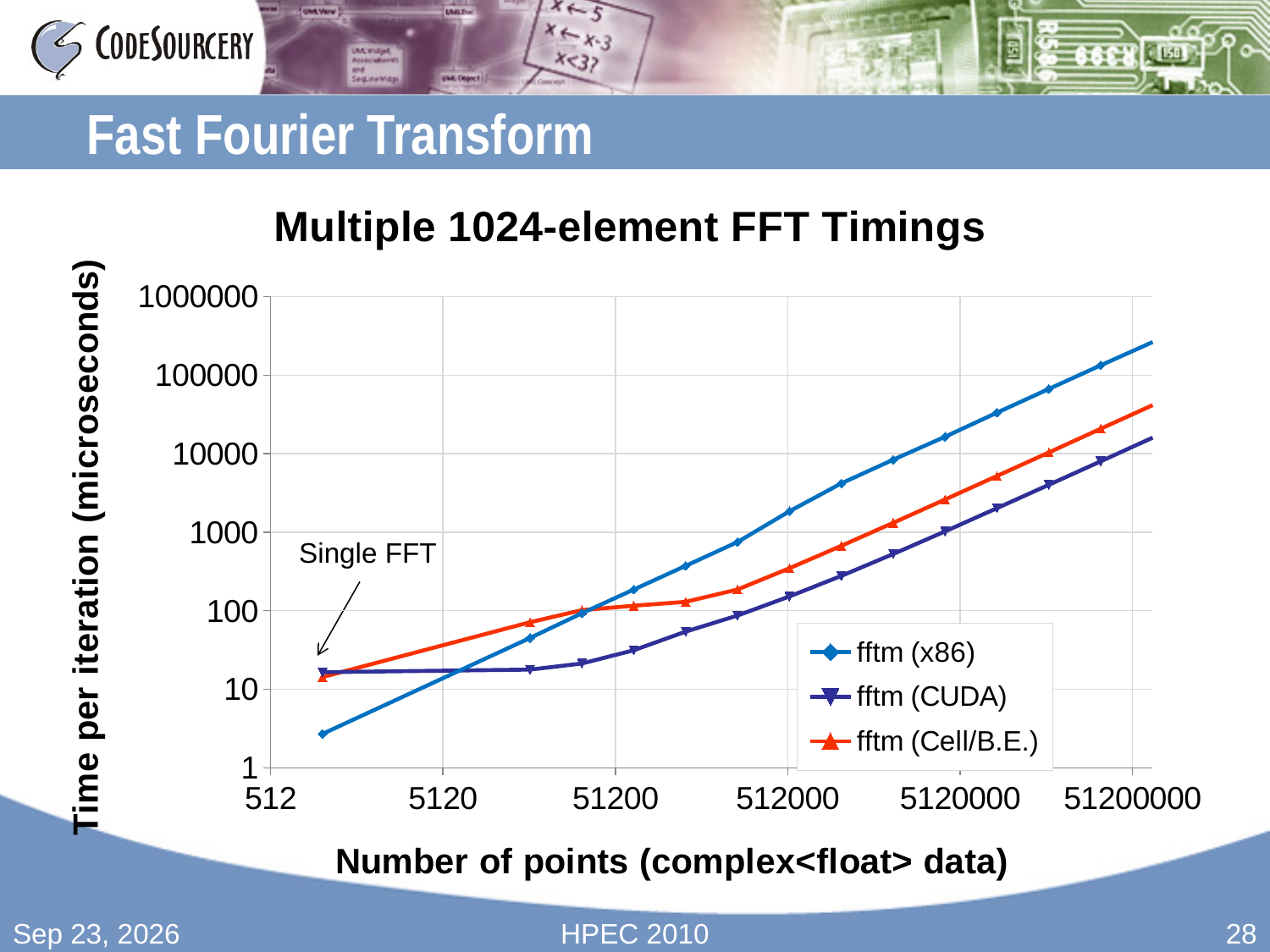
Does the time per iteration for fftm (x86) rise or fall as the number of points increases? rise Is the time per iteration for fftm (x86) at the rightmost point greater or less than 100000? greater What is the title of the chart? Multiple 1024-element FFT Timings Which series has the lowest time per iteration at the smallest number of points? fftm (x86) Which series has the highest time per iteration at the largest number of points? fftm (x86) At the largest number of points, which series has the larger time per iteration, fftm (CUDA) or fftm (Cell/B.E.)? fftm (Cell/B.E.) What label does the arrow annotation near the leftmost data points carry? Single FFT Is the time per iteration for fftm (x86) at the leftmost point greater or less than 10? less Which series has the lowest time per iteration at the largest number of points? fftm (CUDA) How many series does the legend list? 3 Is the time per iteration for fftm (Cell/B.E.) at the rightmost point greater or less than 10000? greater What kind of chart is shown on the slide? line chart